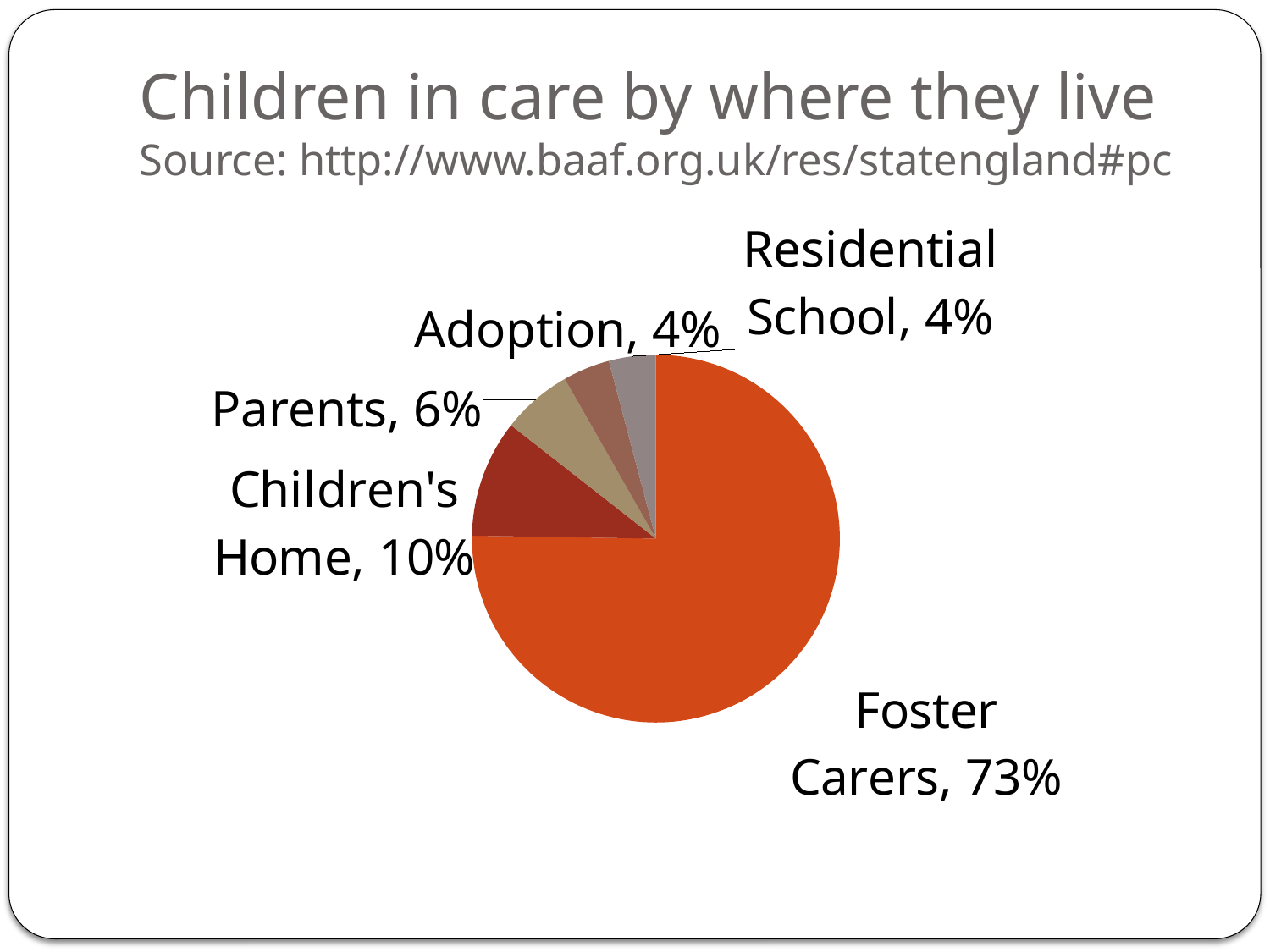
What percentage of children in care live with Parents? 6% What is the difference in percentage points between Foster Carers and Children's Home? 63 Which category has the largest share of the pie? Foster Carers How many categories are shown in the pie chart? 5 Which is larger, the share for Parents or the share for Adoption? Parents What is the difference in percentage points between Children's Home and Parents? 4 What kind of chart is shown on the slide? Pie chart What percentage of children in care live with Foster Carers? 73% What percentage is shown for Residential School? 4% What percentage of children in care live in a Children's Home? 10% What is the title of the chart? Children in care by where they live What percentage is shown for Adoption? 4%